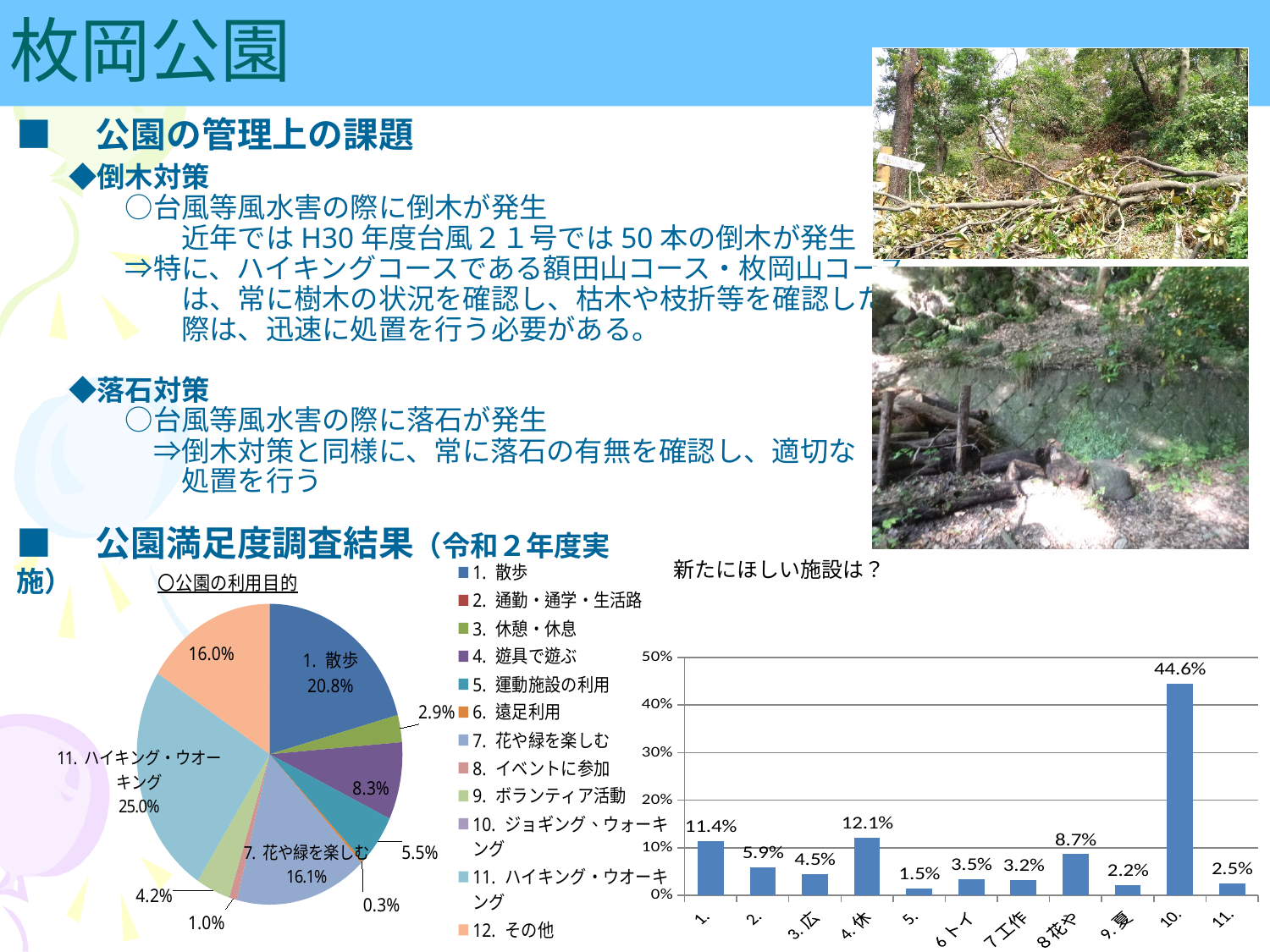
How many categories are shown in the bar chart '新たにほしい施設は？'? 11 In the bar chart '新たにほしい施設は？', what is the difference between the values for category 10. and category 4.休? 32.5% What kind of chart is '新たにほしい施設は？'? bar chart In the bar chart '新たにほしい施設は？', which category has the highest value? 10. In the bar chart '新たにほしい施設は？', what is the value for category 10.? 44.6% In the pie chart '○公園の利用目的', what share does '11. ハイキング・ウオーキング' have? 25.0% In the pie chart '○公園の利用目的', what is the value for '1. 散歩'? 20.8% In the bar chart '新たにほしい施設は？', what is the value for category 4.休? 12.1% In the bar chart '新たにほしい施設は？', which is larger, the value for category 1. or category 4.休? 4.休 How many entries does the legend of the pie chart '○公園の利用目的' list? 12 In the bar chart '新たにほしい施設は？', is the value for category 10. greater or less than 40%? greater In the bar chart '新たにほしい施設は？', which category has the lowest value? 5.